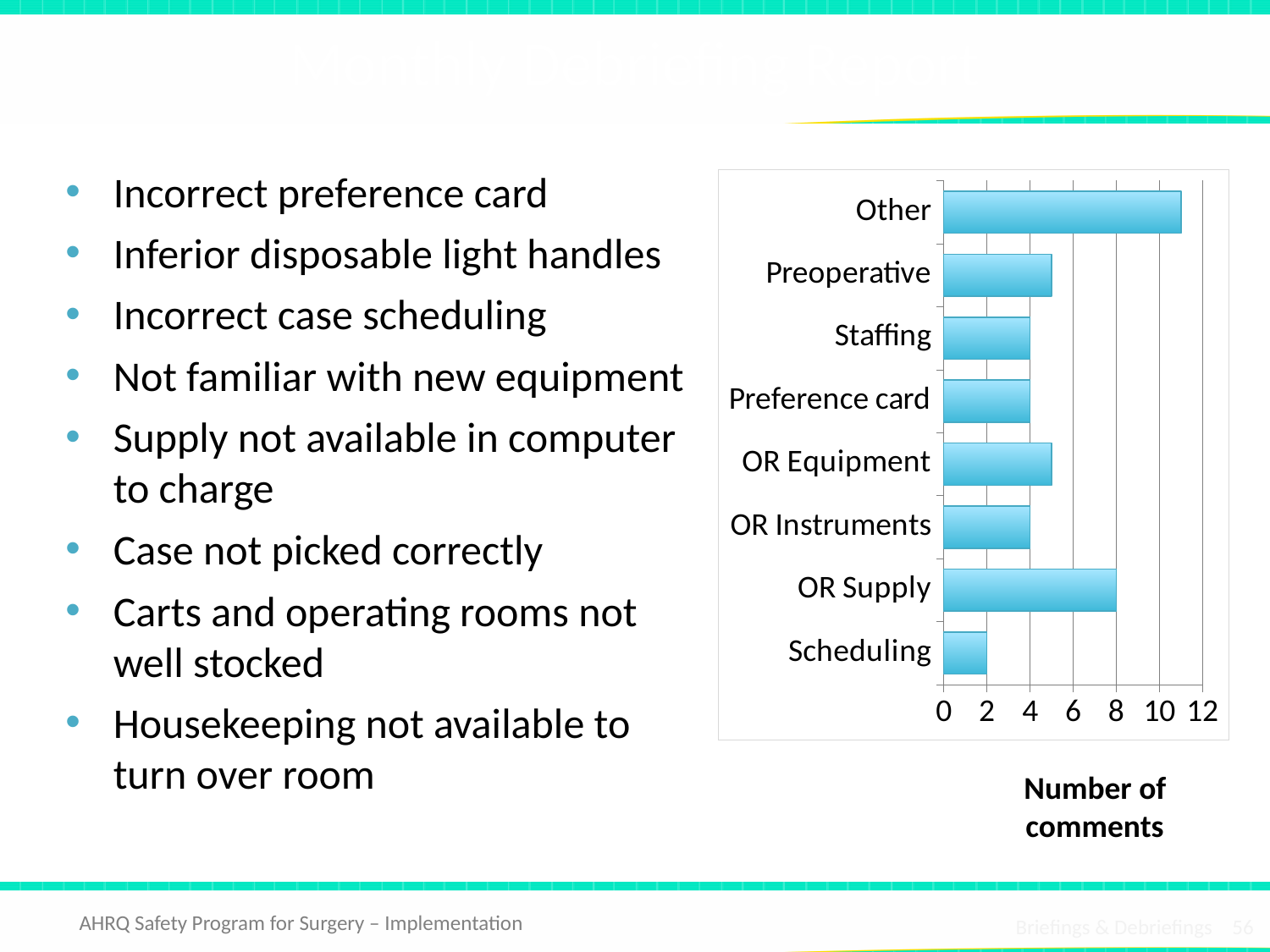
Which category has the lowest number of comments? Scheduling What is the difference between the number of comments for OR Supply and Scheduling? 6 How many categories are shown in the chart? 8 What is the number of comments for Scheduling? 2 Is the value for OR Equipment greater or less than 6? less Which category has the highest number of comments? Other What is the label of the horizontal axis of the chart? Number of comments Is the value for Preoperative greater or less than 4? greater What is the number of comments for OR Supply? 8 What type of chart is shown on the slide? bar chart Is the value for Other greater or less than 10? greater Which has more comments, OR Supply or Preoperative? OR Supply